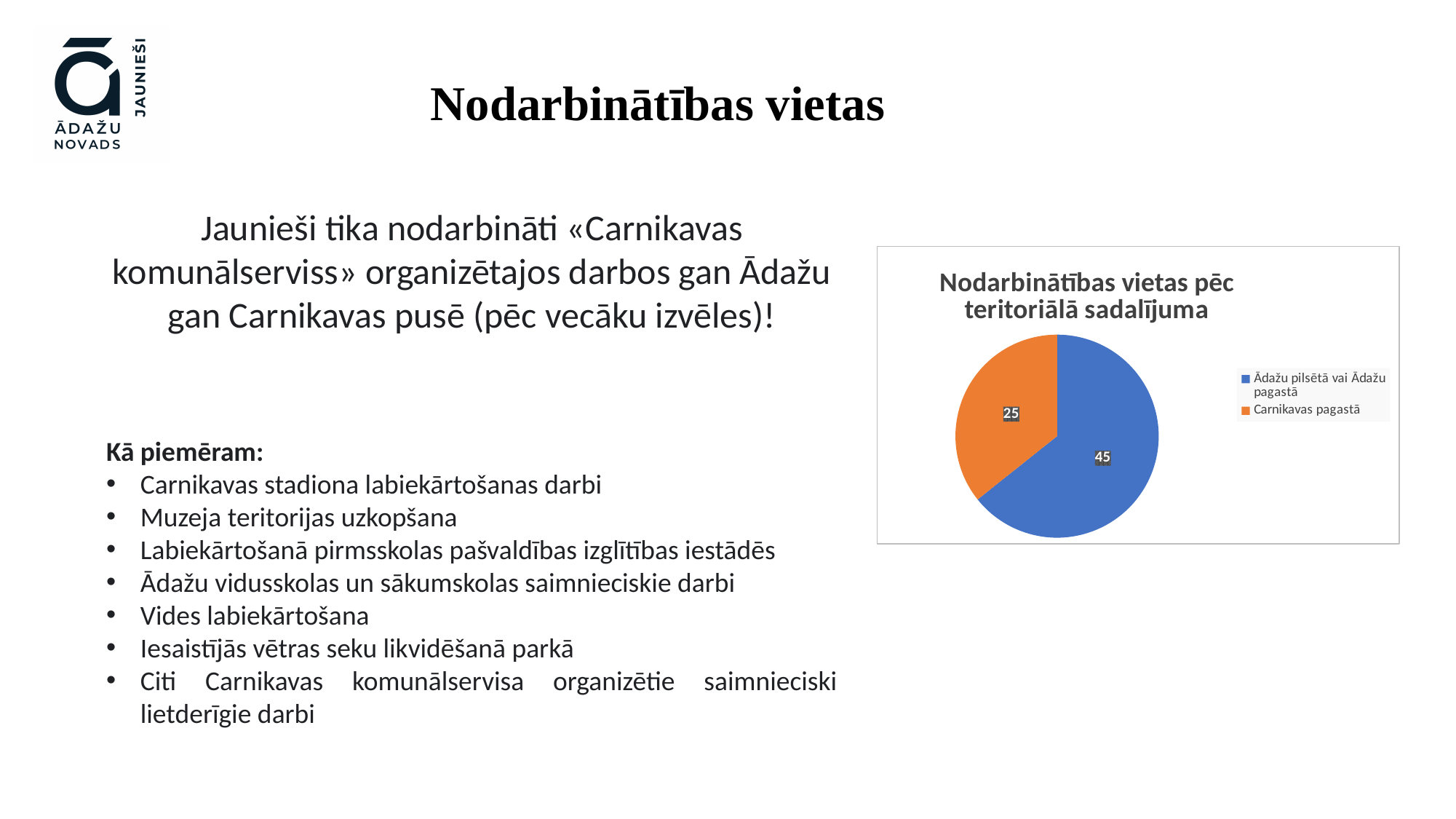
How many slices does the pie chart have? 2 What is the value for Carnikavas pagastā? 25 Which category has the smallest slice of the pie? Carnikavas pagastā What is the value for Ādažu pilsētā vai Ādažu pagastā? 45 Which is larger, the value for Ādažu pilsētā vai Ādažu pagastā or the value for Carnikavas pagastā? Ādažu pilsētā vai Ādažu pagastā How many entries does the legend list? 2 Which category has the largest slice of the pie? Ādažu pilsētā vai Ādažu pagastā What colour is the slice for Carnikavas pagastā? orange What is the title of the chart? Nodarbinātības vietas pēc teritoriālā sadalījuma What is the difference between the values for Ādažu pilsētā vai Ādažu pagastā and Carnikavas pagastā? 20 What is the total of all slices in the pie chart? 70 What type of chart is shown on the slide? pie chart